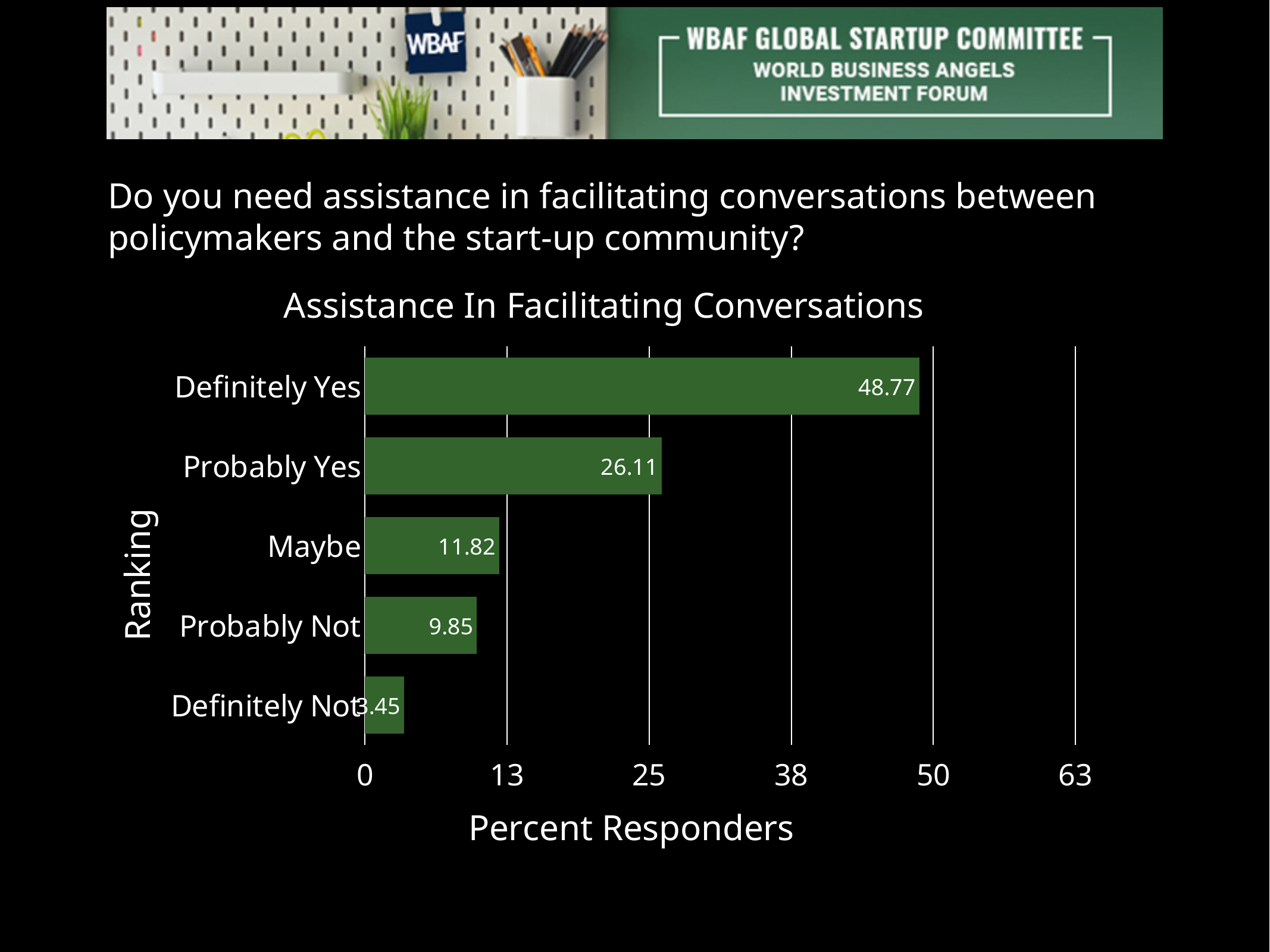
What is the value for Maybe? 11.82 Which category has the lowest value? Definitely Not What is the difference between the values for Definitely Yes and Probably Yes? 22.66 What is the value for Definitely Yes? 48.77 Which category has the highest value? Definitely Yes What is the value for Probably Yes? 26.11 What is the title of the chart? Assistance In Facilitating Conversations What is the value for Definitely Not? 3.45 How many categories are shown in the chart? 5 Which is larger, the value for Maybe or the value for Probably Not? Maybe What kind of chart is shown on the slide? Bar chart What is the value for Probably Not? 9.85